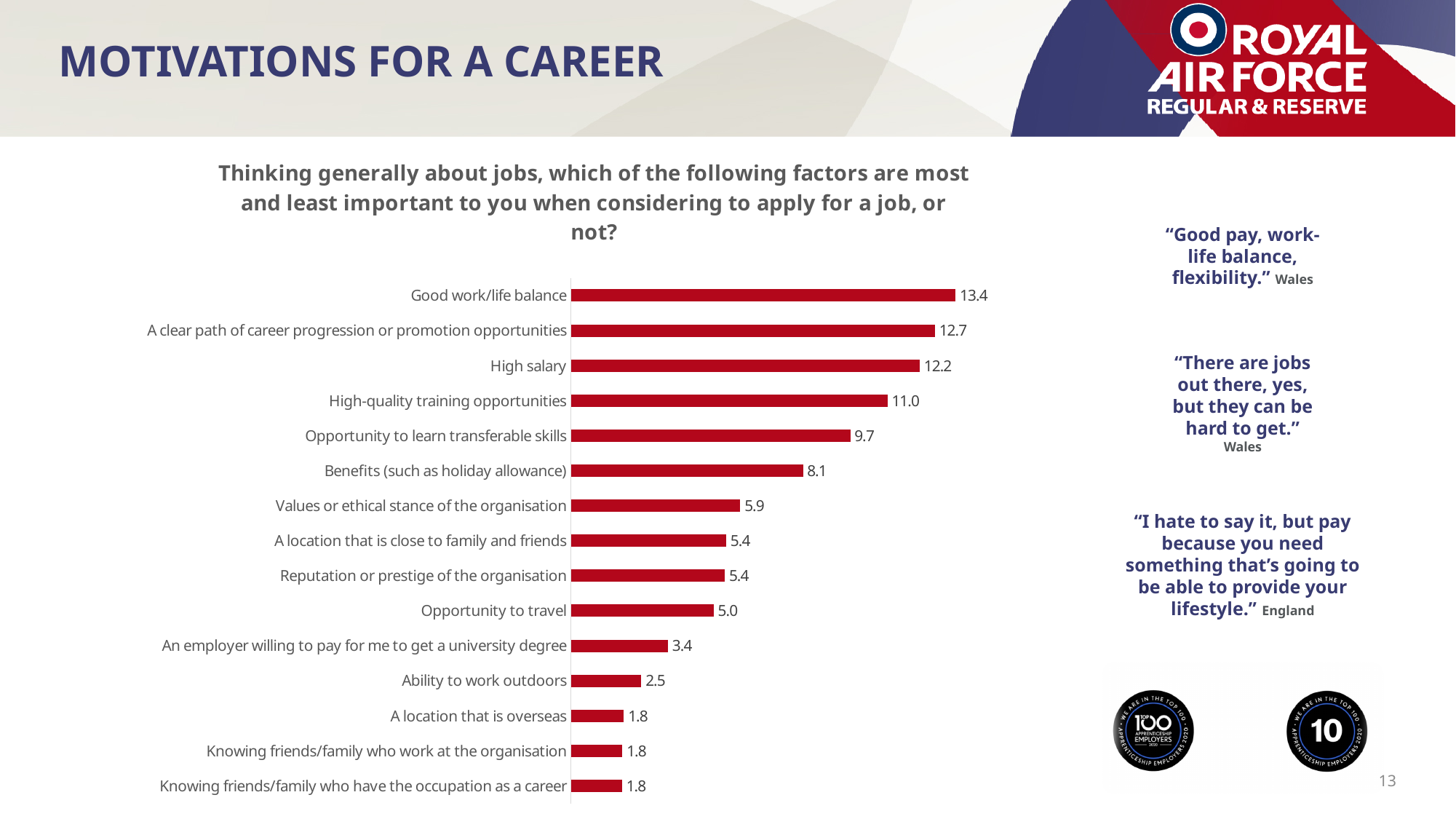
How many categories are shown on the chart? 15 What kind of chart is shown on the slide? Bar chart What is the difference between the values for Good work/life balance and High salary? 1.2 What is the value for Ability to work outdoors? 2.5 What is the value for Good work/life balance? 13.4 What is the value for Benefits (such as holiday allowance)? 8.1 Which category has the highest value? Good work/life balance What is the lowest value shown on the chart? 1.8 Which is larger: the value for High salary or the value for A clear path of career progression or promotion opportunities? A clear path of career progression or promotion opportunities What is the difference between the values for Opportunity to learn transferable skills and Opportunity to travel? 4.7 What colour are the bars in the chart? Red What is the value for High-quality training opportunities? 11.0